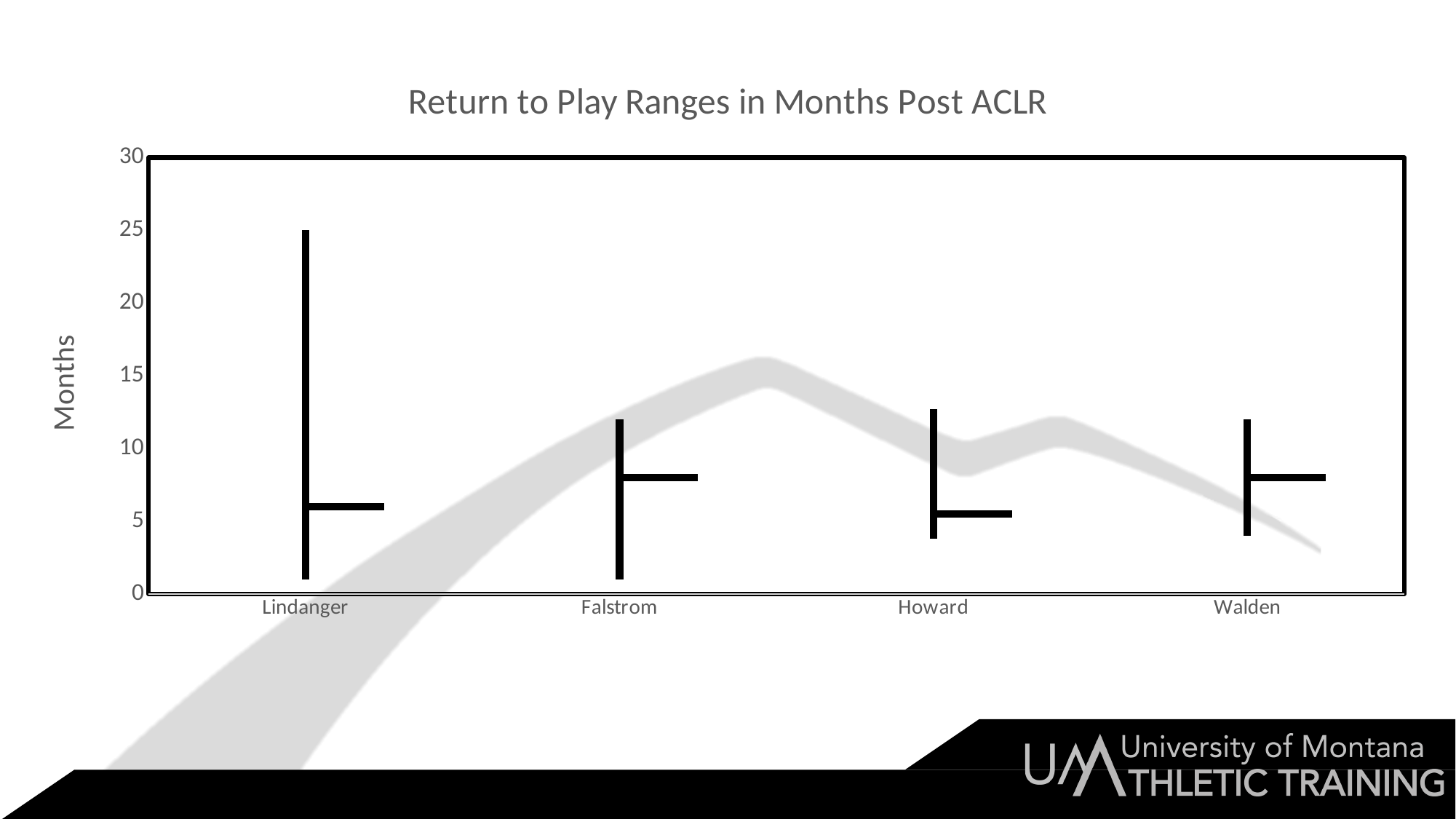
Is the upper end of the range for Lindanger greater or less than 20? greater Is the upper end of the range for Falstrom greater or less than 10? greater Which has a higher horizontal marker value, Lindanger or Falstrom? Falstrom Which has a higher upper end of its range, Lindanger or Walden? Lindanger Which category has the highest upper end of its range? Lindanger What is the label on the vertical axis of the chart? Months How many categories are shown along the x axis of the chart? 4 Is the upper end of the range for Howard greater or less than 15? less What is the highest value shown on the vertical axis? 30 What is the title of the chart? Return to Play Ranges in Months Post ACLR